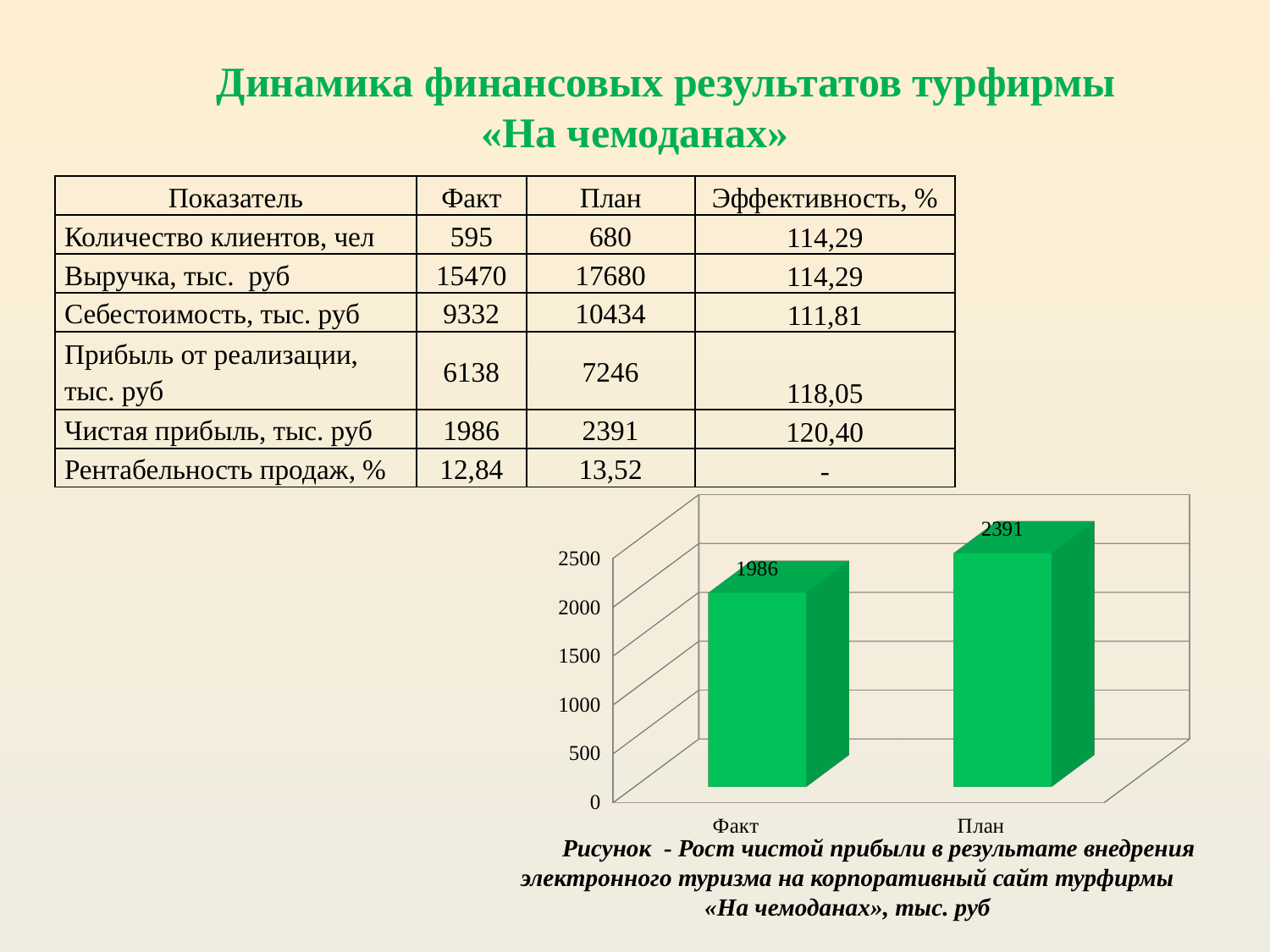
What is the highest value shown on the vertical axis of the chart? 2500 What is the value of the План bar in the chart? 2391 Which category has the higher value in the chart, Факт or План? План What kind of chart is shown on the slide? bar chart Which category has the lower value in the chart? Факт How many bars are plotted in the chart? 2 Is the value for Факт greater or less than 2000? less What colour are the bars in the chart? green What is the value of the Факт bar in the chart? 1986 What is the difference between the План and Факт values in the chart? 405 Is the value for План greater or less than 2000? greater Do the values rise or fall from Факт to План in the chart? rise